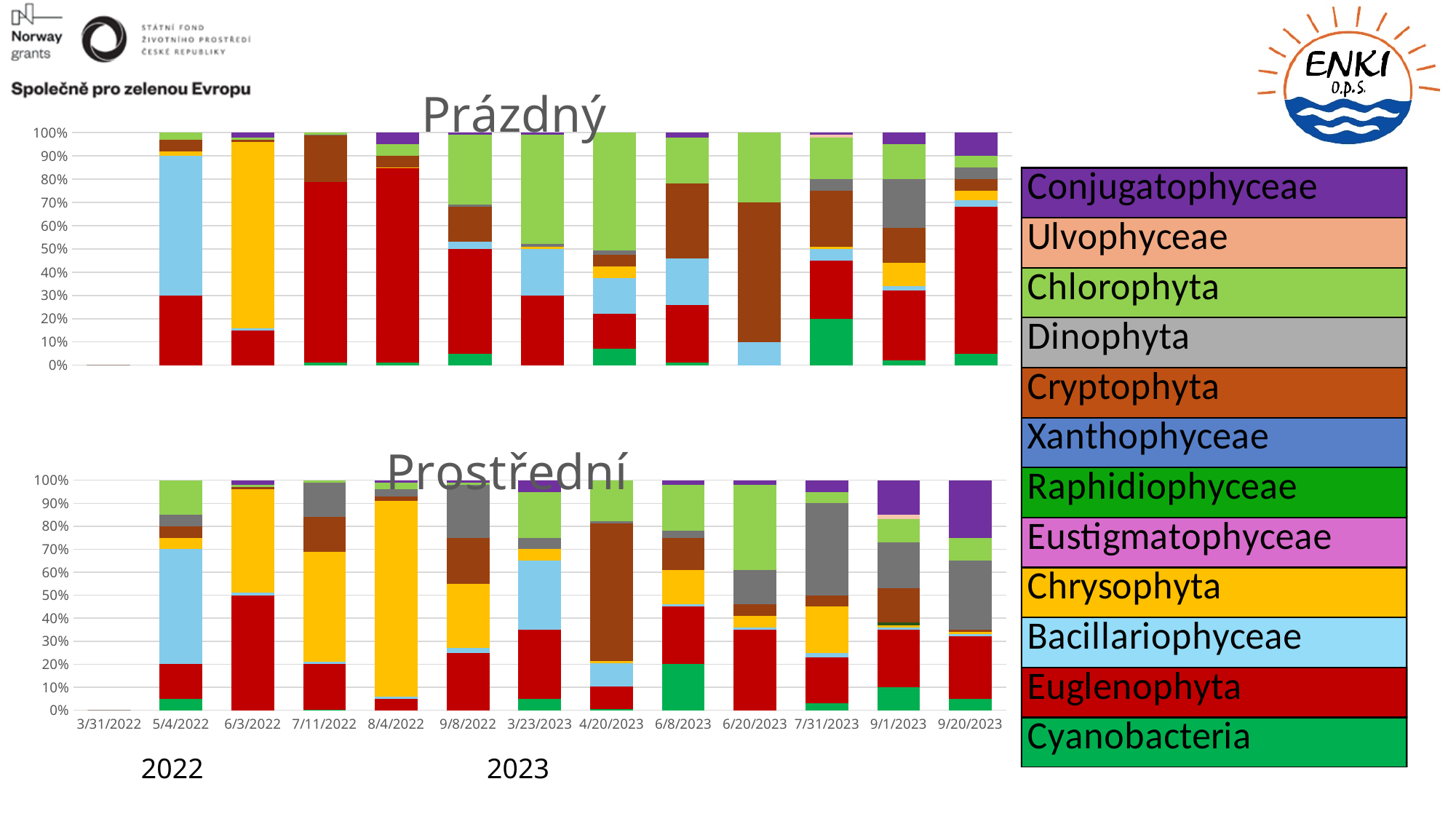
What kind of chart is the top chart titled "Prázdný"? Stacked bar chart How many dates are shown along the x axis of the bottom chart "Prostřední"? 13 In the bottom chart "Prostřední", is the Cryptophyta share for 4/20/2023 greater or less than 50%? greater In the bottom chart "Prostřední", which is larger for 7/11/2022: the Chrysophyta share or the Euglenophyta share? Chrysophyta In the top chart "Prázdný", is the Bacillariophyceae share for 5/4/2022 greater or less than 50%? greater How many series does the legend on the right list? 12 In the bottom chart "Prostřední", is the Chrysophyta share for 8/4/2022 greater or less than 80%? greater In the top chart "Prázdný", which is larger for 5/4/2022: the Bacillariophyceae share or the Euglenophyta share? Bacillariophyceae What is the title of the bottom chart? Prostřední